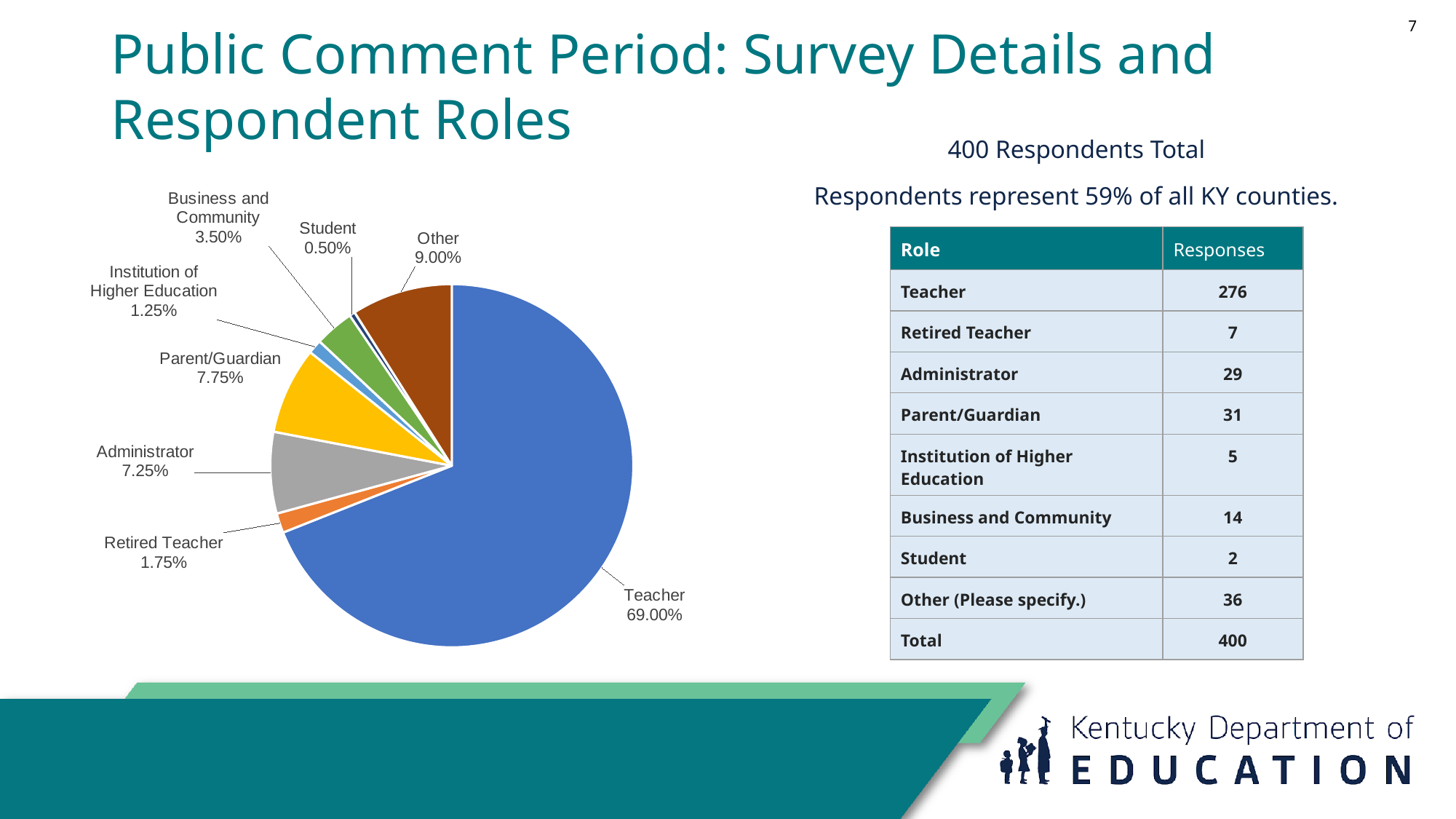
What colour is the Teacher slice in the pie chart? blue Which category has the largest slice of the pie chart? Teacher Which is larger in the pie chart, Parent/Guardian or Administrator? Parent/Guardian What share of the pie does Teacher represent? 69.00% What percentage is shown for Business and Community in the pie chart? 3.50% What percentage is shown for Other in the pie chart? 9.00% What type of chart is shown on the slide? pie chart What percentage is shown for Administrator in the pie chart? 7.25% What is the difference in percentage points between Other and Parent/Guardian in the pie chart? 1.25 How many slices does the pie chart have? 8 What percentage is shown for Parent/Guardian in the pie chart? 7.75% Which category has the smallest slice of the pie chart? Student